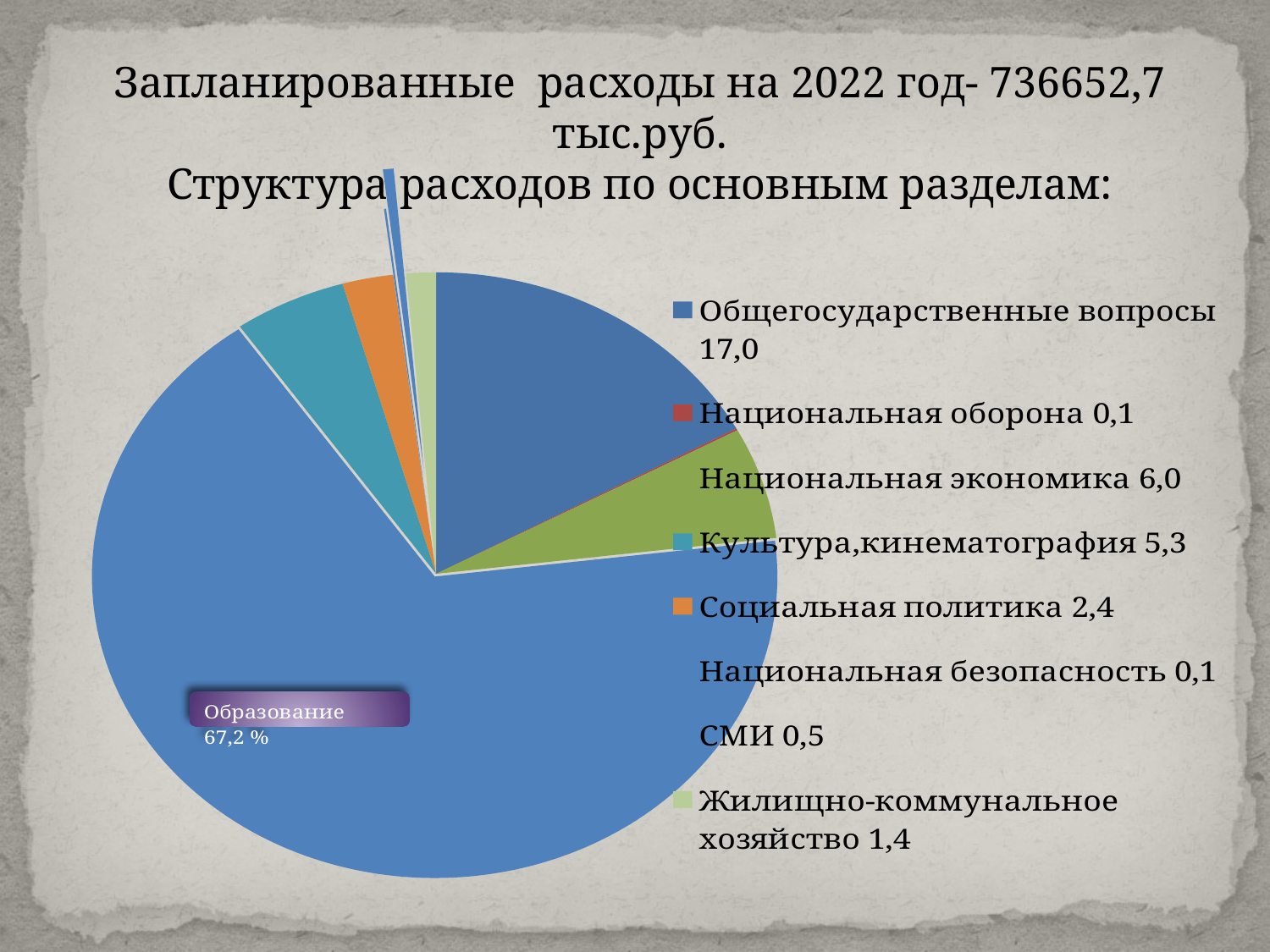
What value is shown for Национальная экономика? 6,0 What value is shown for Жилищно-коммунальное хозяйство? 1,4 How many entries does the legend list? 8 What kind of chart is shown on the slide? pie chart Which category has the largest slice of the pie? Образование What share of the pie does Образование take? 67,2 % What is the difference between the values for Общегосударственные вопросы and Национальная экономика? 11,0 What value is shown for Социальная политика? 2,4 What value is shown for Общегосударственные вопросы? 17,0 What value is shown for Культура,кинематография? 5,3 Which is larger, Национальная экономика or Культура,кинематография? Национальная экономика What value is shown for СМИ? 0,5